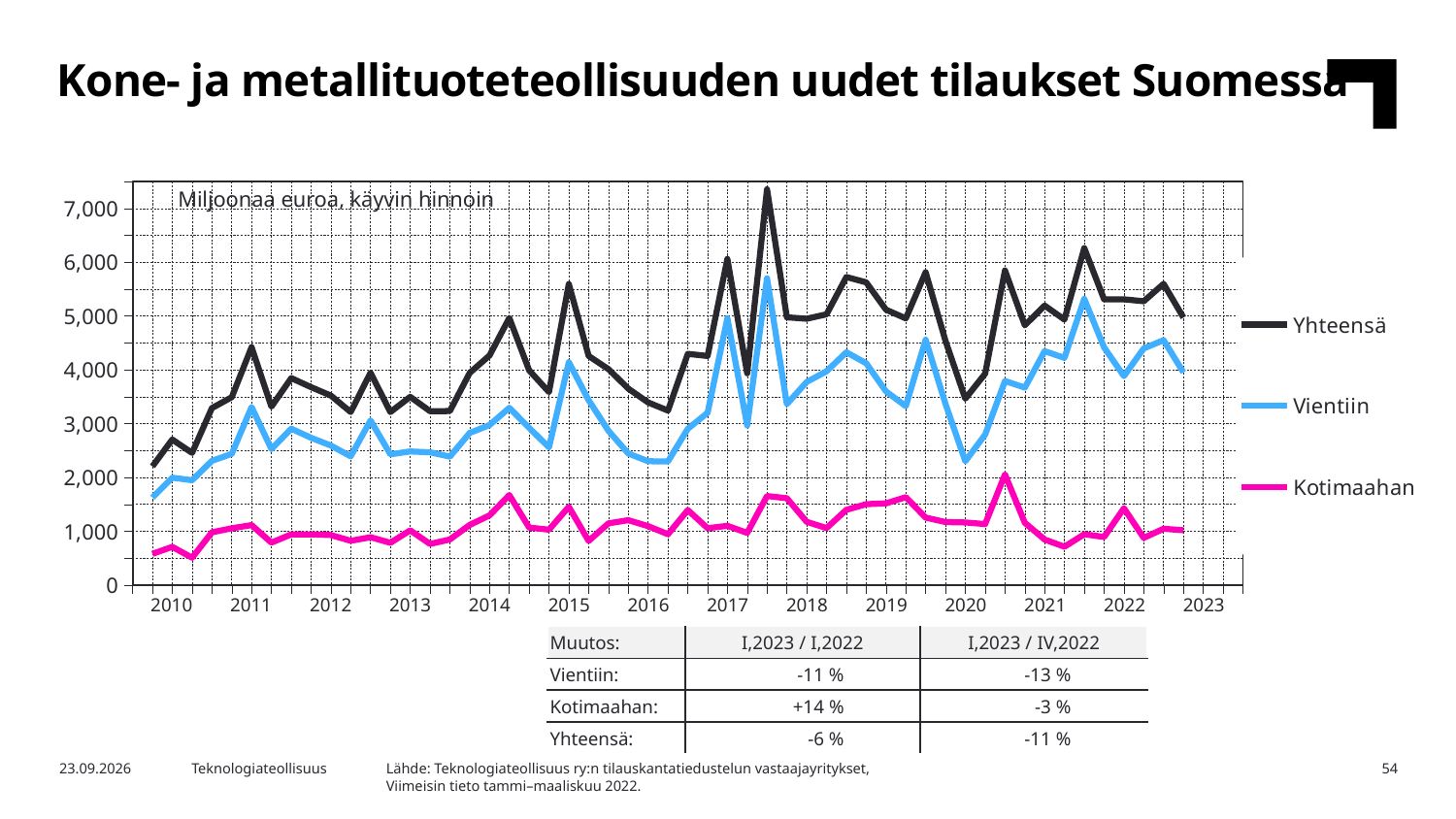
Is the value of the Kotimaahan series at the start of 2010 greater or less than 1,000? less What unit note is printed inside the chart area? Miljoonaa euroa, käyvin hinnoin In which year does the Yhteensä series reach its highest peak? 2017 Which series has the highest values throughout the chart? Yhteensä Which series is higher at every point, Vientiin or Kotimaahan? Vientiin What kind of chart is shown on the slide? line chart Is the peak value of the Yhteensä series in 2017 greater or less than 7,000? greater How many series does the legend list? 3 Does the Yhteensä series overall rise or fall from 2010 to its 2017 peak? rise Which series are listed in the chart legend? Yhteensä, Vientiin, Kotimaahan Which series has the lowest values throughout the chart? Kotimaahan Is the last plotted value of the Vientiin series (2023) greater or less than 5,000? less